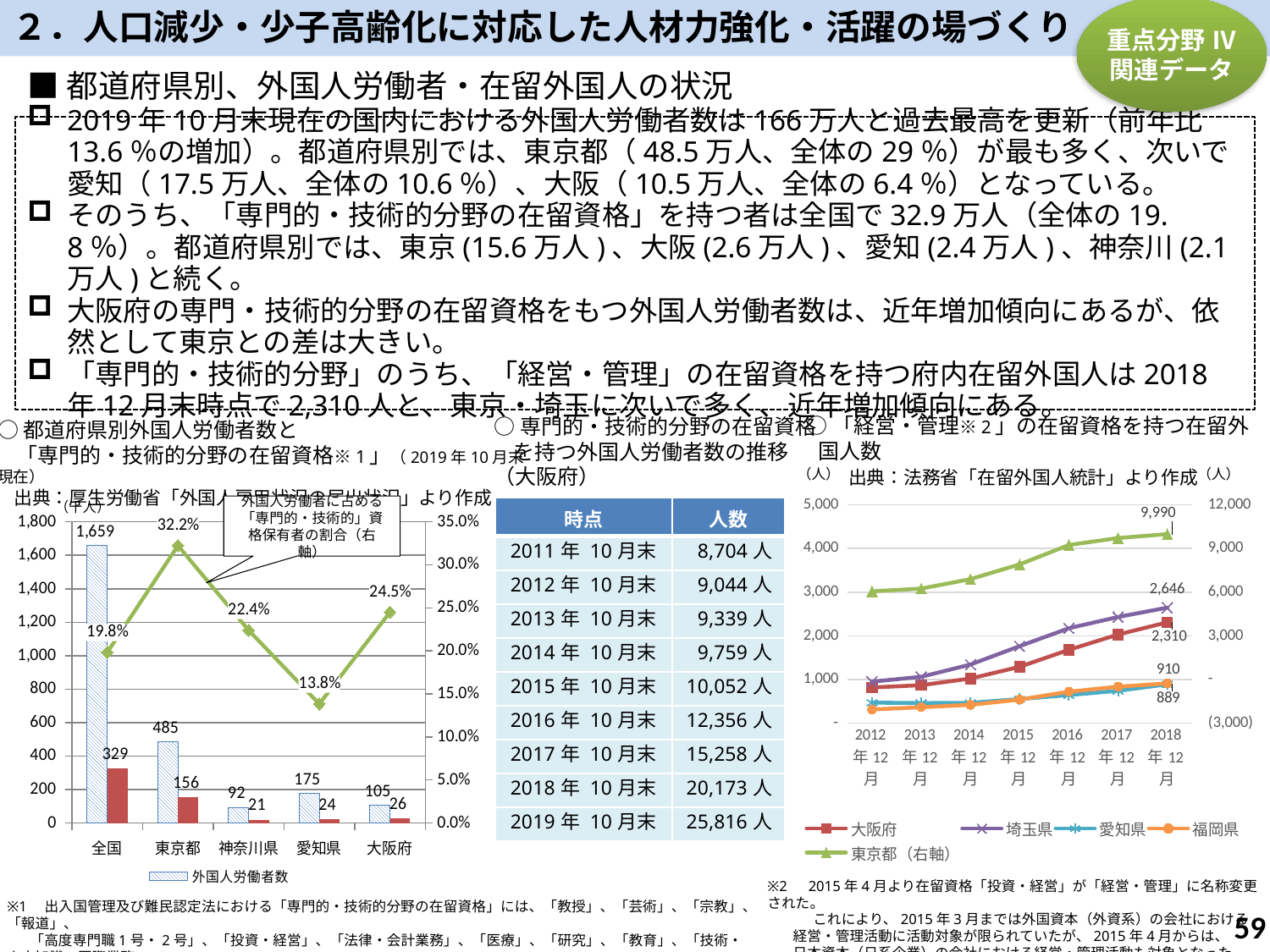
What kind of chart is the right chart (「経営・管理」の在留資格を持つ在留外国人数)? line chart In the left chart (都道府県別外国人労働者数と「専門的・技術的分野の在留資格」), which has the larger 外国人労働者数, 愛知県 or 神奈川県? 愛知県 In the left chart (都道府県別外国人労働者数と「専門的・技術的分野の在留資格」), which prefecture has the lowest share of 「専門的・技術的」資格保有者? 愛知県 In the right chart (「経営・管理」の在留資格を持つ在留外国人数), what is the value for 大阪府 at 2018年12月? 2,310 In the left chart (都道府県別外国人労働者数と「専門的・技術的分野の在留資格」), what is the difference in 外国人労働者数 between 東京都 and 大阪府? 380 In the left chart (都道府県別外国人労働者数と「専門的・技術的分野の在留資格」), what is the 外国人労働者数 value for 全国? 1,659 In the right chart (「経営・管理」の在留資格を持つ在留外国人数), what is the value for 東京都 at 2018年12月? 9,990 In the left chart (都道府県別外国人労働者数と「専門的・技術的分野の在留資格」), what is the 外国人労働者数 value for 東京都? 485 In the right chart (「経営・管理」の在留資格を持つ在留外国人数), how many series does the legend list? 5 In the left chart (都道府県別外国人労働者数と「専門的・技術的分野の在留資格」), how many categories are shown on the x axis? 5 In the left chart (都道府県別外国人労働者数と「専門的・技術的分野の在留資格」), what is the share of 「専門的・技術的」資格保有者 shown for 東京都? 32.2% In the right chart (「経営・管理」の在留資格を持つ在留外国人数), does the value for 大阪府 rise or fall from 2012年12月 to 2018年12月? rise